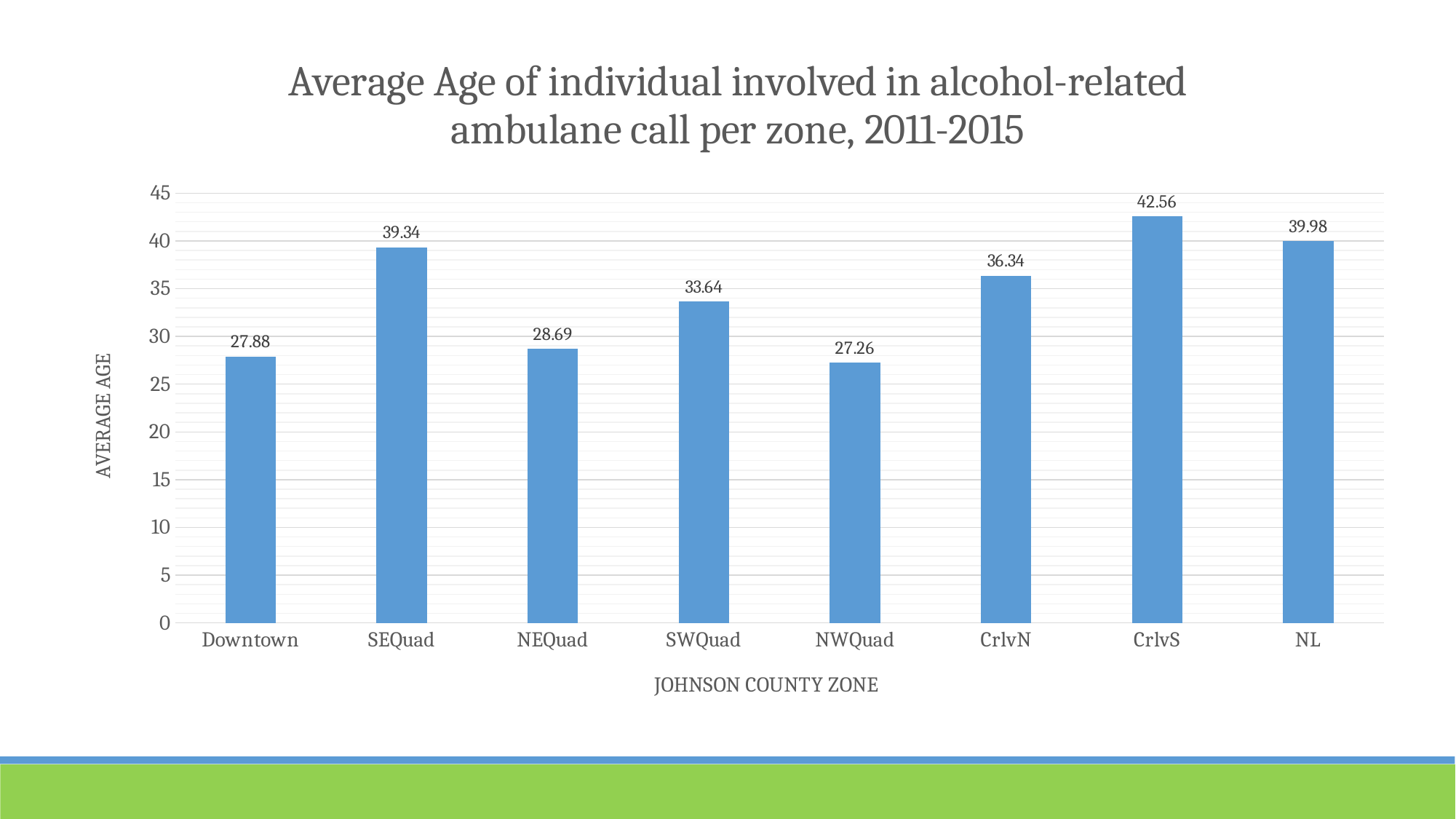
Which zone has a higher average age, SWQuad or CrlvN? CrlvN What is the average age for the CrlvS zone? 42.56 What is the difference in average age between SEQuad and NEQuad? 10.65 Which zone has the highest average age? CrlvS What is the difference in average age between CrlvS and NWQuad? 15.30 How many zones are shown on the chart? 8 Is the value for CrlvN greater or less than 35? greater What is the label of the x axis? JOHNSON COUNTY ZONE What is the average age for the Downtown zone? 27.88 Which zone has the lowest average age? NWQuad What kind of chart is shown on the slide? Bar chart What is the average age for the NL zone? 39.98